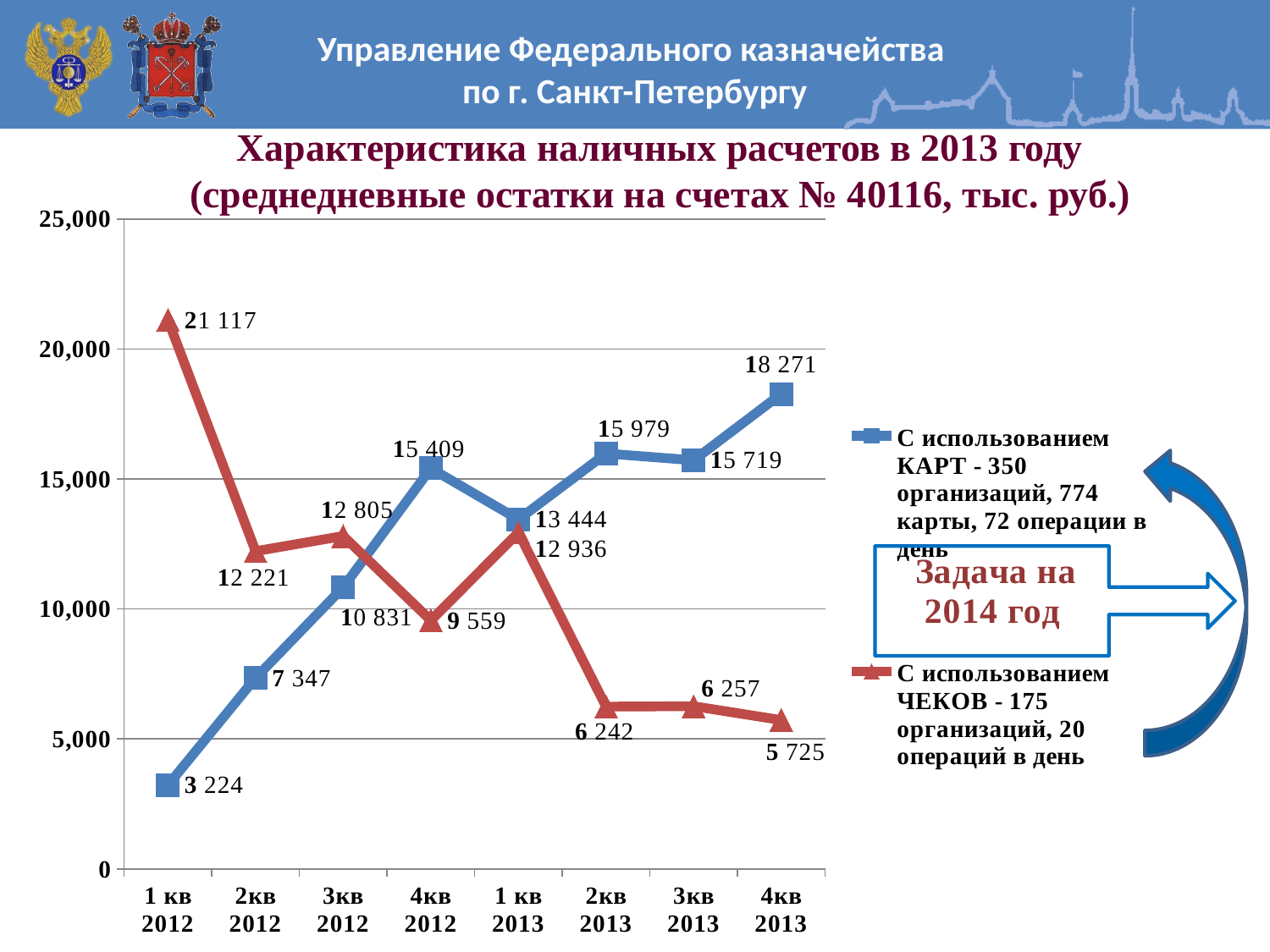
What is the difference between the cards value and the cheques value in 4кв 2013? 12 546 What is the value for the cards series in 1 кв 2012? 3 224 What is the value for the cheques series (С использованием ЧЕКОВ) in 1 кв 2012? 21 117 Does the cheques series generally rise or fall from 1 кв 2012 to 4кв 2013? fall In which quarter is the cards series at its highest? 4кв 2013 What type of chart is shown on the slide? line chart In which quarter is the cheques series at its lowest? 4кв 2013 What is the value for the cards series (С использованием КАРТ) in 4кв 2013? 18 271 How many quarters are plotted along the x axis? 8 Which series has the larger value in 2кв 2012, cards or cheques? cheques (С использованием ЧЕКОВ) According to the legend, how many organisations use cards (КАРТ)? 350 How many series does the legend list? 2